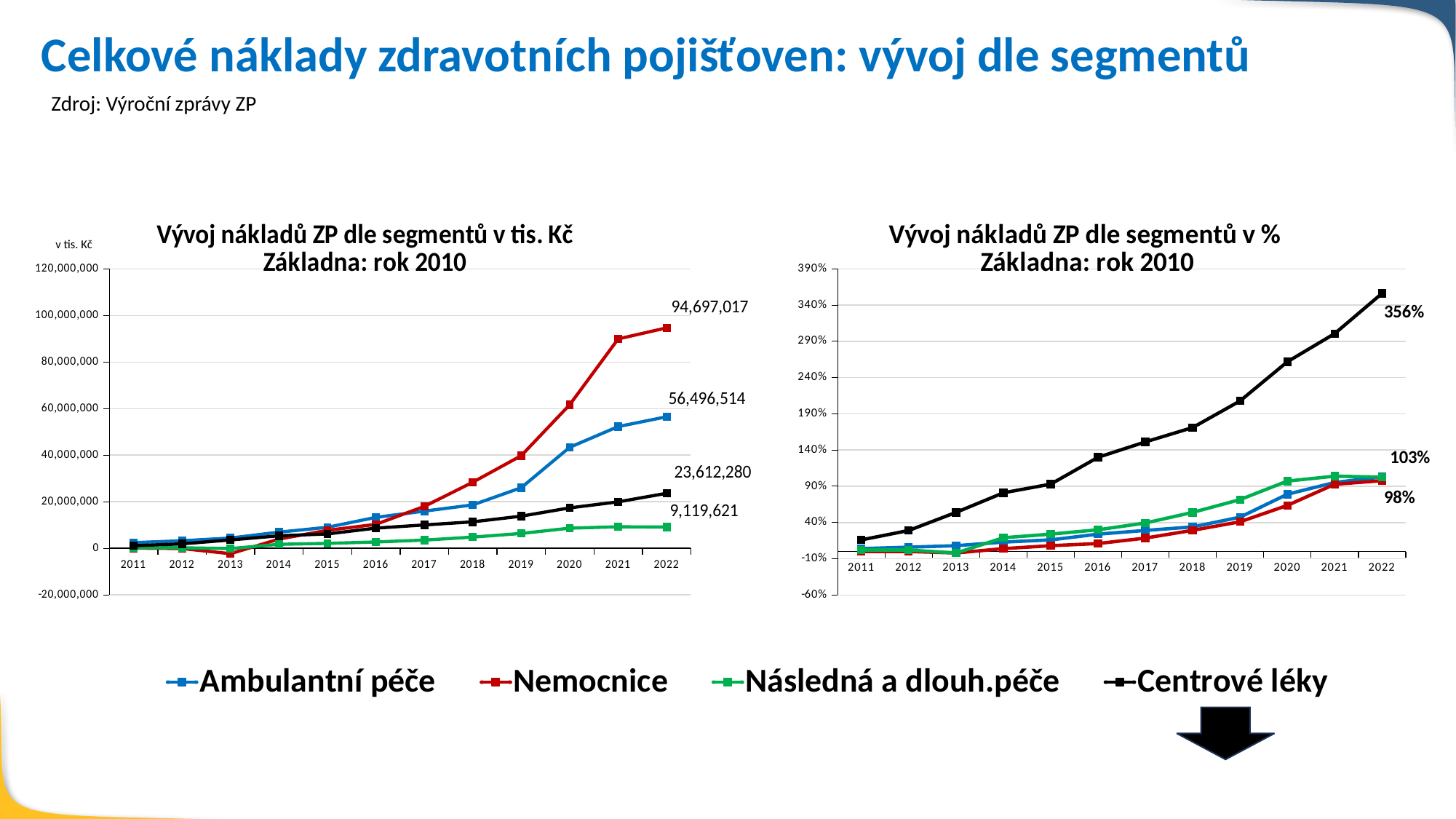
In the right chart (v %), is the value for Centrové léky in 2020 greater or less than 240%? greater In the right chart (v %), which segment has the highest value in 2022? Centrové léky In the left chart (v tis. Kč), what is the difference between Nemocnice and Ambulantní péče in 2022? 38,200,503 In the left chart (v tis. Kč), what is the value for Nemocnice in 2022? 94,697,017 In the left chart (v tis. Kč), what is the value for Ambulantní péče in 2022? 56,496,514 In the left chart (v tis. Kč), which segment has the highest value in 2022? Nemocnice In the left chart (v tis. Kč), what is the value for Následná a dlouh.péče in 2022? 9,119,621 In the right chart (v %), what is the value for Centrové léky in 2022? 356% What kind of chart is the left chart, 'Vývoj nákladů ZP dle segmentů v tis. Kč'? line chart How many series does the legend list? 4 In the left chart (v tis. Kč), what is the value for Centrové léky in 2022? 23,612,280 How many years are shown on the x axis of the left chart? 12